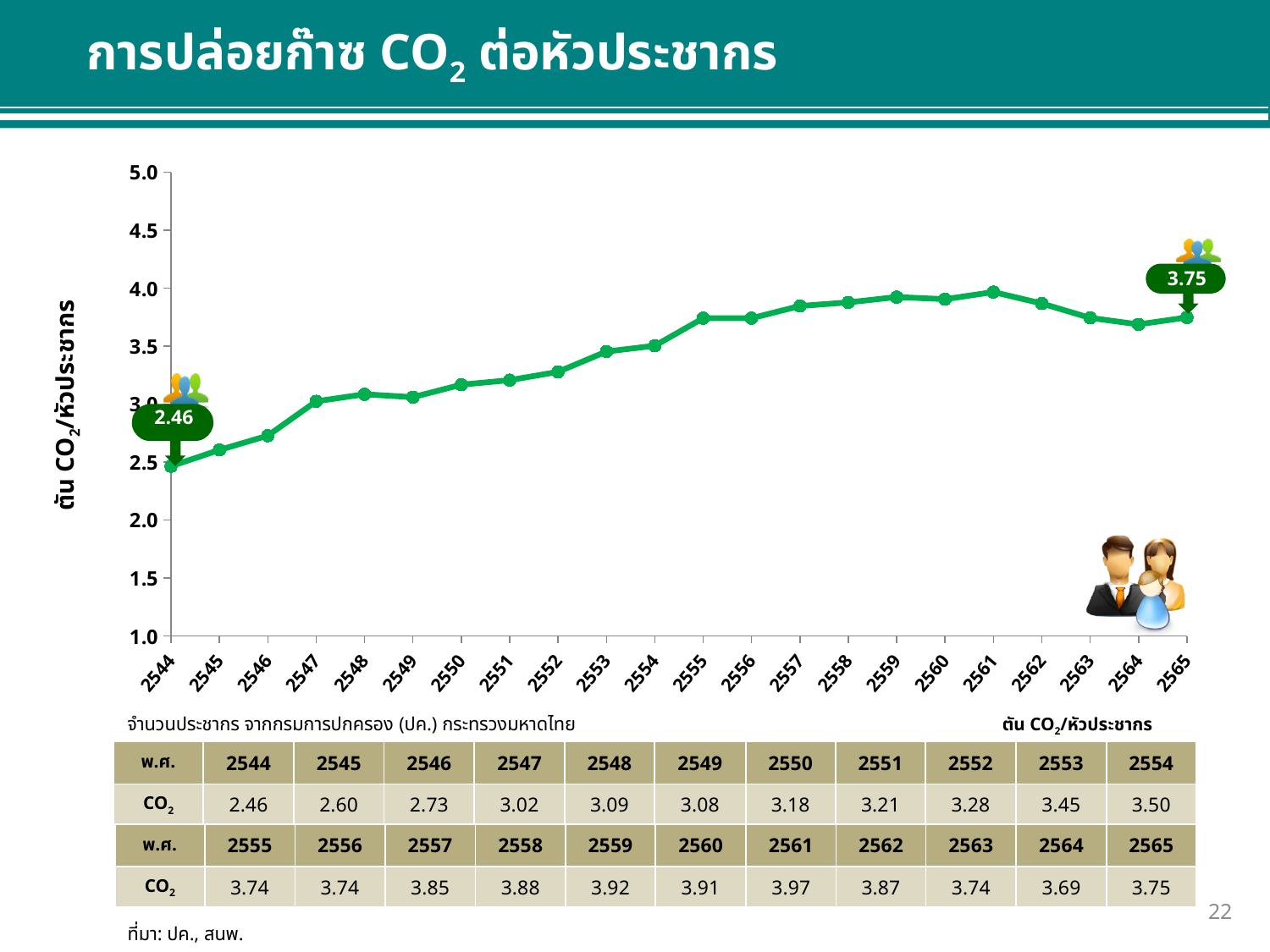
What is the CO2 emission per capita value for the year 2544? 2.46 Which year has the lowest CO2 emission per capita? 2544 What is the difference between the CO2 emission per capita in 2565 and in 2544? 1.29 What is the CO2 emission per capita value for the year 2550? 3.18 How many years are plotted on the x axis of the chart? 22 What type of chart is shown on the slide? line chart Is the CO2 emission per capita for 2559 greater or less than 3.5? greater Which year has the highest CO2 emission per capita? 2561 What is the CO2 emission per capita value for the year 2561? 3.97 Which year has a higher CO2 emission per capita, 2557 or 2564? 2557 What is the CO2 emission per capita value for the year 2565? 3.75 What is the label of the vertical axis of the chart? ตัน CO2/หัวประชากร